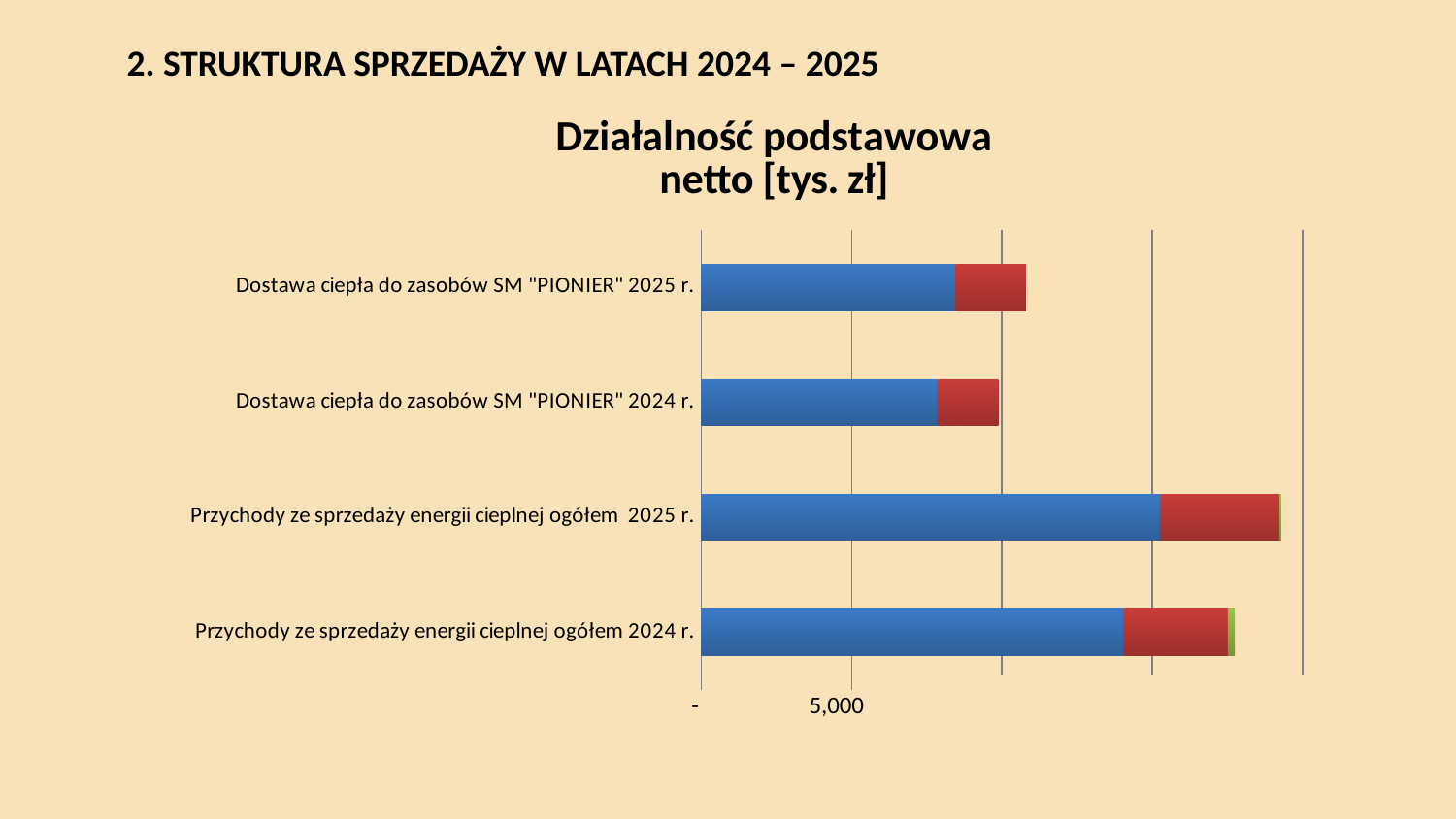
Is the total value for Przychody ze sprzedaży energii cieplnej ogółem 2025 r. greater or less than 15,000? greater What is the title of the chart? Działalność podstawowa netto [tys. zł] Is the total value for Przychody ze sprzedaży energii cieplnej ogółem 2025 r. greater or less than 20,000? less Which category has the shortest bar overall? Dostawa ciepła do zasobów SM "PIONIER" 2024 r. What is the only numeric tick label printed on the horizontal axis? 5,000 Which bar is longer: Przychody ze sprzedaży energii cieplnej ogółem 2025 r. or Przychody ze sprzedaży energii cieplnej ogółem 2024 r.? Przychody ze sprzedaży energii cieplnej ogółem 2025 r. What kind of chart is shown on the slide? bar chart Is the total value for Przychody ze sprzedaży energii cieplnej ogółem 2024 r. greater or less than 15,000? greater How many categories (bars) does the chart show? 4 Which category has the longest bar overall? Przychody ze sprzedaży energii cieplnej ogółem 2025 r. Which bar is longer: Dostawa ciepła do zasobów SM "PIONIER" 2025 r. or Dostawa ciepła do zasobów SM "PIONIER" 2024 r.? Dostawa ciepła do zasobów SM "PIONIER" 2025 r.